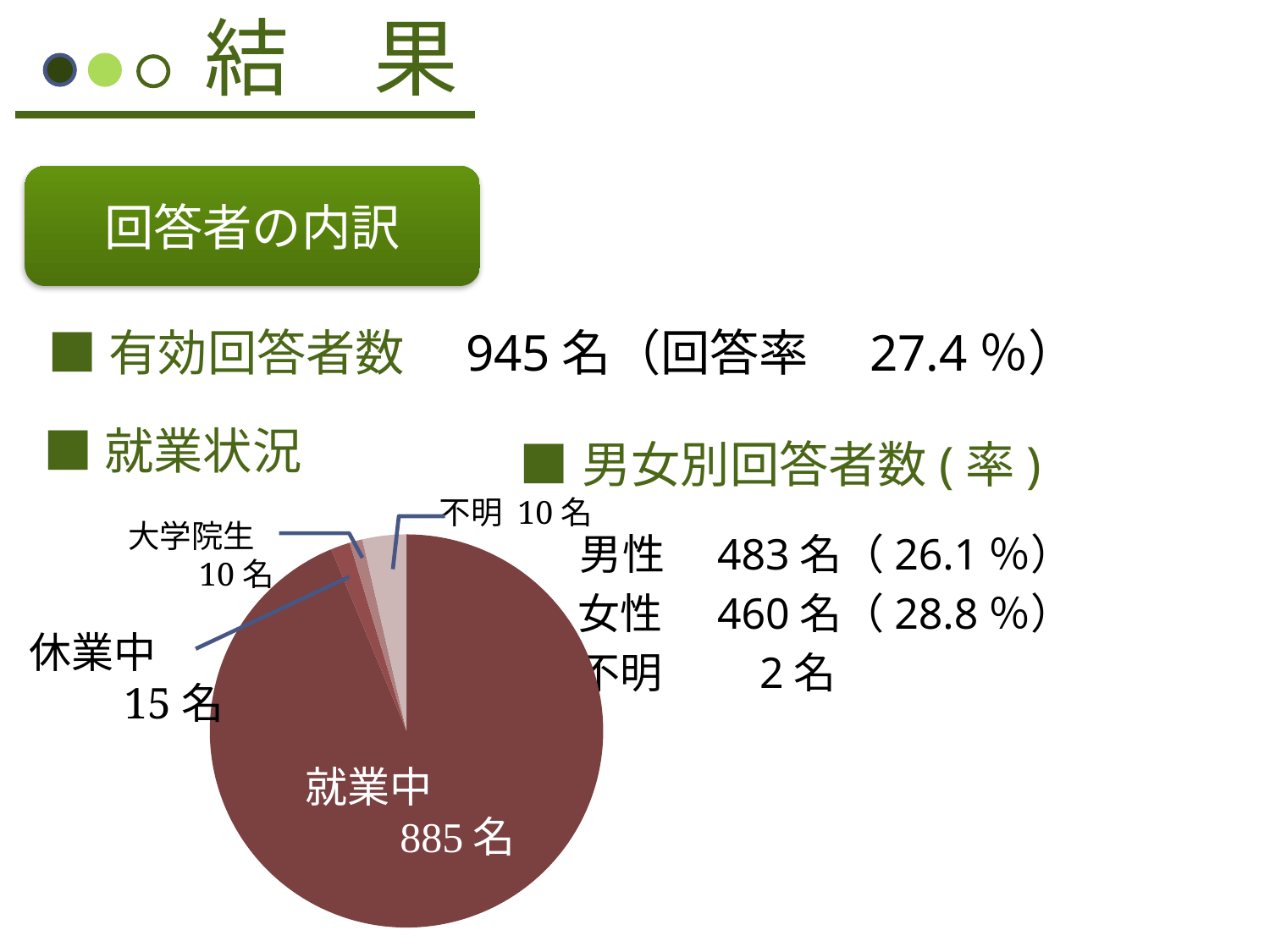
What is the value for 大学院生 in the pie chart? 10 名 What is the value for 不明 in the pie chart? 10 名 How many slices does the pie chart have? 4 What heading is shown above the pie chart? 就業状況 What kind of chart is shown on the slide? pie chart Which is larger, the value for 休業中 or the value for 大学院生? 休業中 What is the value for 休業中 in the pie chart? 15 名 What is the value for 就業中 in the pie chart? 885 名 What is the difference between the values for 就業中 and 休業中? 870 名 Which category has the largest slice in the pie chart? 就業中 What colour is the largest slice of the pie chart? dark reddish brown What is the difference between the values for 休業中 and 大学院生? 5 名